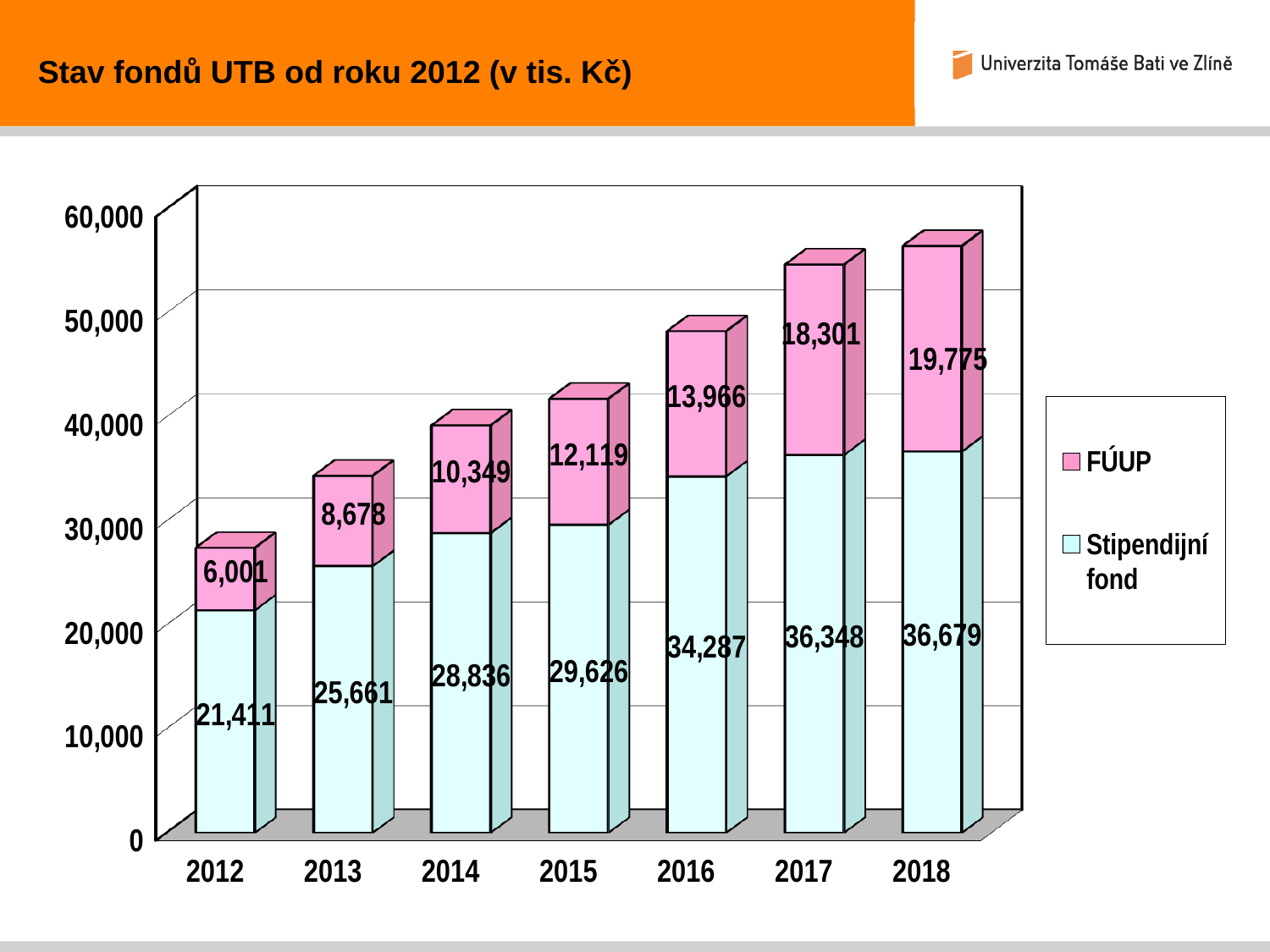
What is the value of FÚUP in 2017? 18,301 Do the Stipendijní fond values rise or fall from 2012 to 2018? Rise How many series does the legend list? 2 What is the difference between the FÚUP values in 2018 and 2012? 13,774 In which year is the Stipendijní fond value lowest? 2012 What kind of chart is shown on the slide? Stacked bar chart Which is larger: Stipendijní fond in 2014 or Stipendijní fond in 2015? Stipendijní fond in 2015 What is the value of Stipendijní fond in 2012? 21,411 How many years are shown on the x axis? 7 In which year is the FÚUP value highest? 2018 What is the value of Stipendijní fond in 2016? 34,287 What is the total of the stacked bar for 2018? 56,454